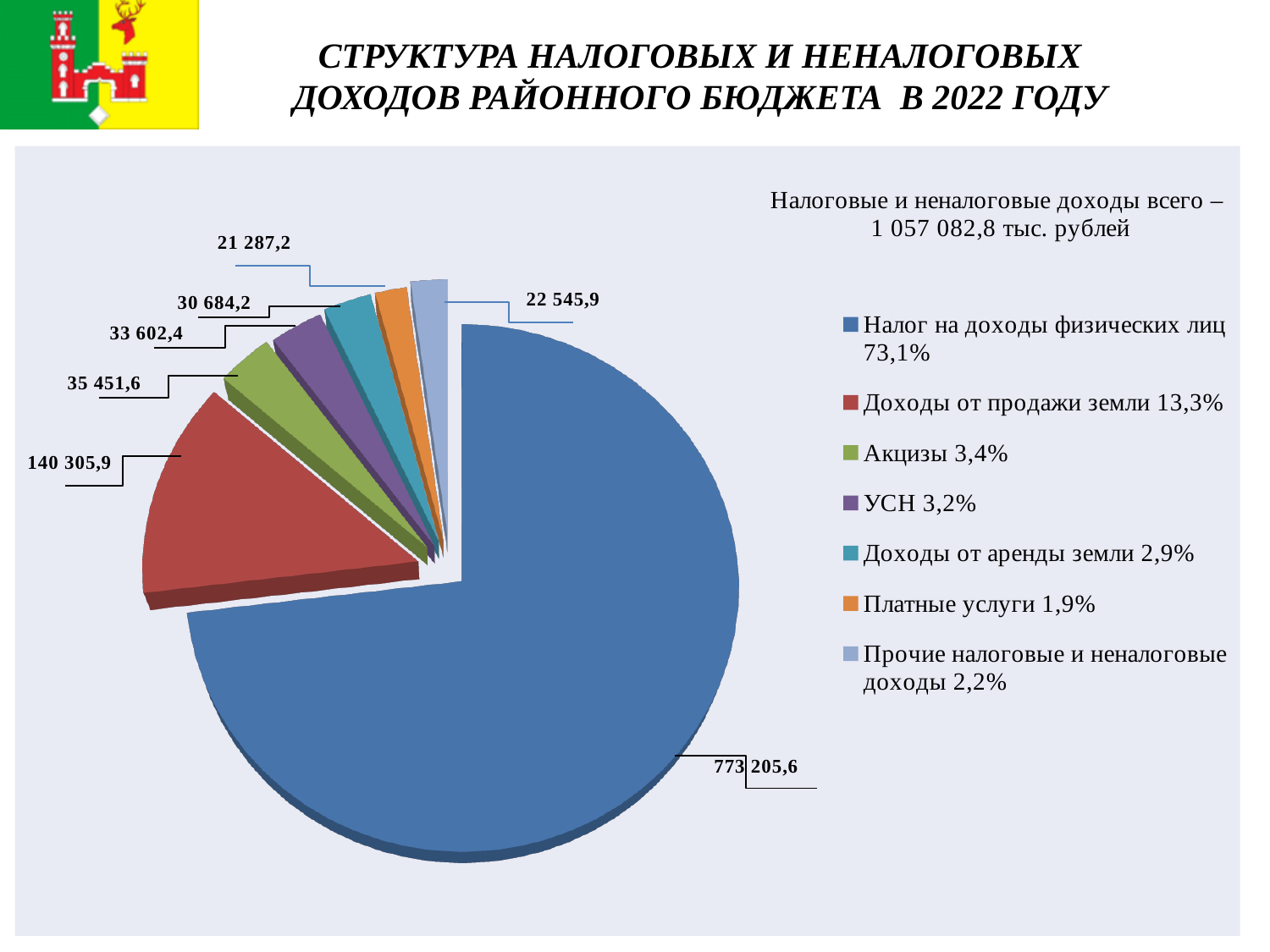
How many slices does the pie chart have? 7 Which is larger, the value for УСН or the value for Доходы от аренды земли? УСН Which category has the largest slice of the pie? Налог на доходы физических лиц What is the total of all tax and non-tax revenues shown on the slide? 1 057 082,8 тыс. рублей What is the value shown for Доходы от продажи земли? 140 305,9 What is the value shown for Налог на доходы физических лиц? 773 205,6 What share of the pie does Доходы от продажи земли represent? 13,3% Which category has the smallest slice of the pie? Платные услуги What is the value shown for Акцизы? 35 451,6 What kind of chart is shown on the slide? Pie chart What is the difference between the values for Налог на доходы физических лиц and Доходы от продажи земли? 632 899,7 What is the value shown for Платные услуги? 21 287,2